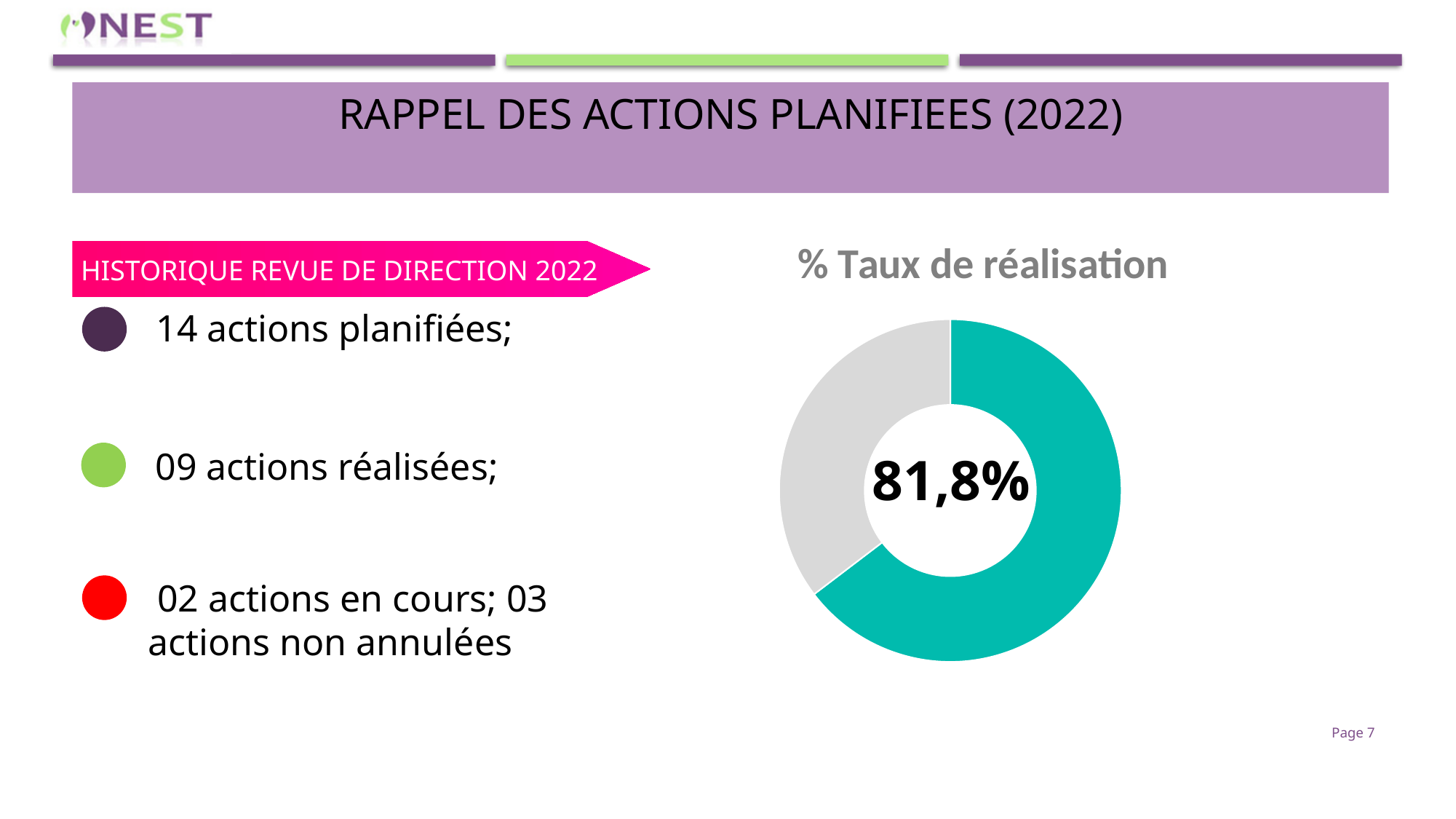
How many slices does the doughnut chart have? 2 What is the title of the chart on the right of the slide? % Taux de réalisation Which slice of the doughnut chart is larger, the teal one or the grey one? the teal one Is the teal slice of the doughnut chart greater or less than half of the ring? greater What value is printed in the centre of the doughnut chart? 81,8% What is the realisation rate (taux de réalisation) shown on the chart? 81,8% What colour is the larger slice of the doughnut chart? teal What kind of chart is shown under the title "% Taux de réalisation"? doughnut chart